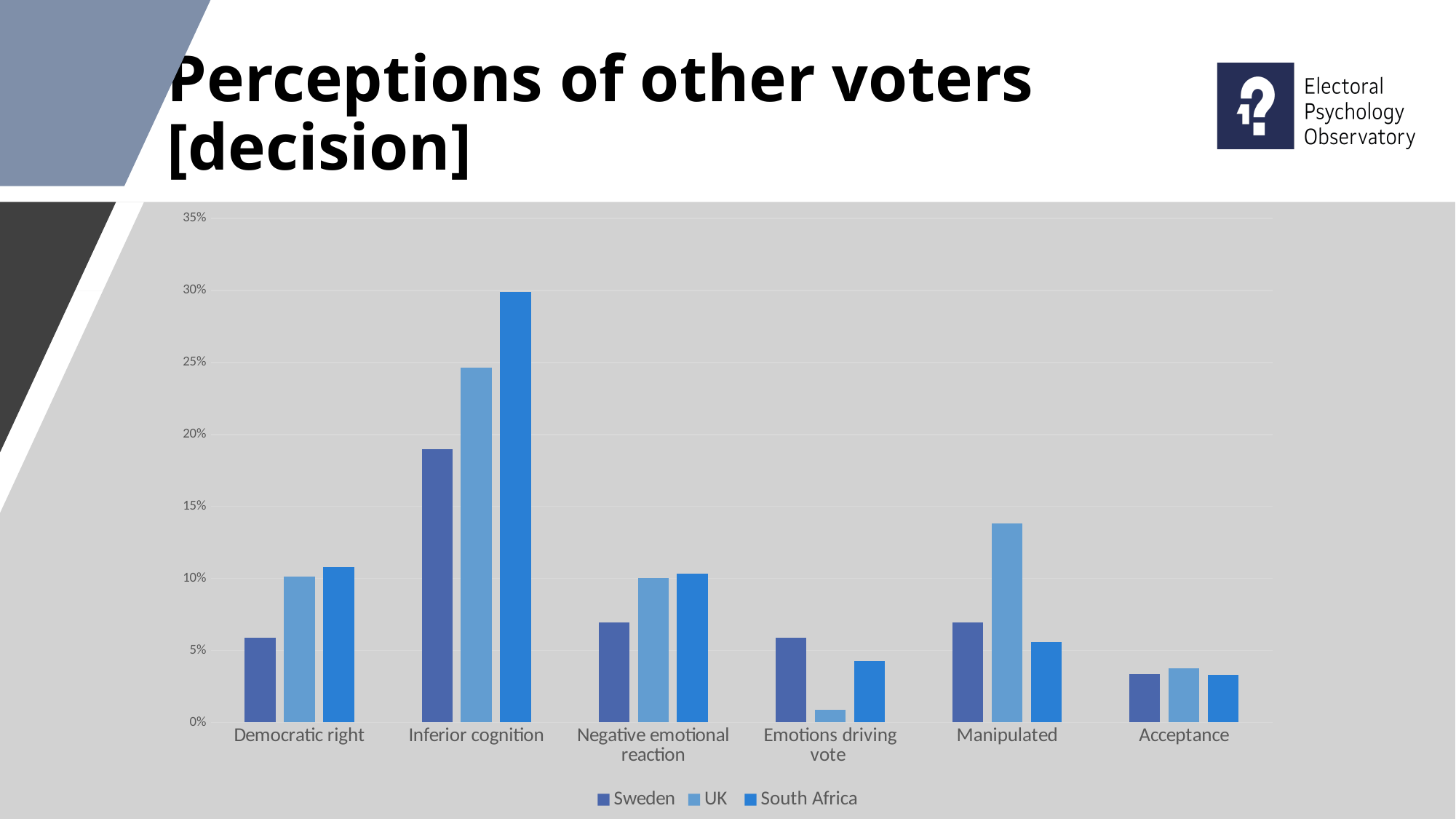
For the Manipulated category, which series has the highest bar? UK Is the South Africa value for Inferior cognition greater or less than 25%? greater How many series does the legend list? 3 For Manipulated, which is larger: the UK value or the South Africa value? UK For Emotions driving vote, which is larger: the Sweden value or the UK value? Sweden Which series has the lowest bar in the Emotions driving vote category? UK What kind of chart is shown on the slide? Bar chart Is the Sweden value for Inferior cognition greater or less than 15%? greater Which category has the highest South Africa bar? Inferior cognition Is the UK value for Manipulated greater or less than 10%? greater How many categories are shown on the x axis? 6 What are the three series listed in the legend? Sweden, UK, South Africa